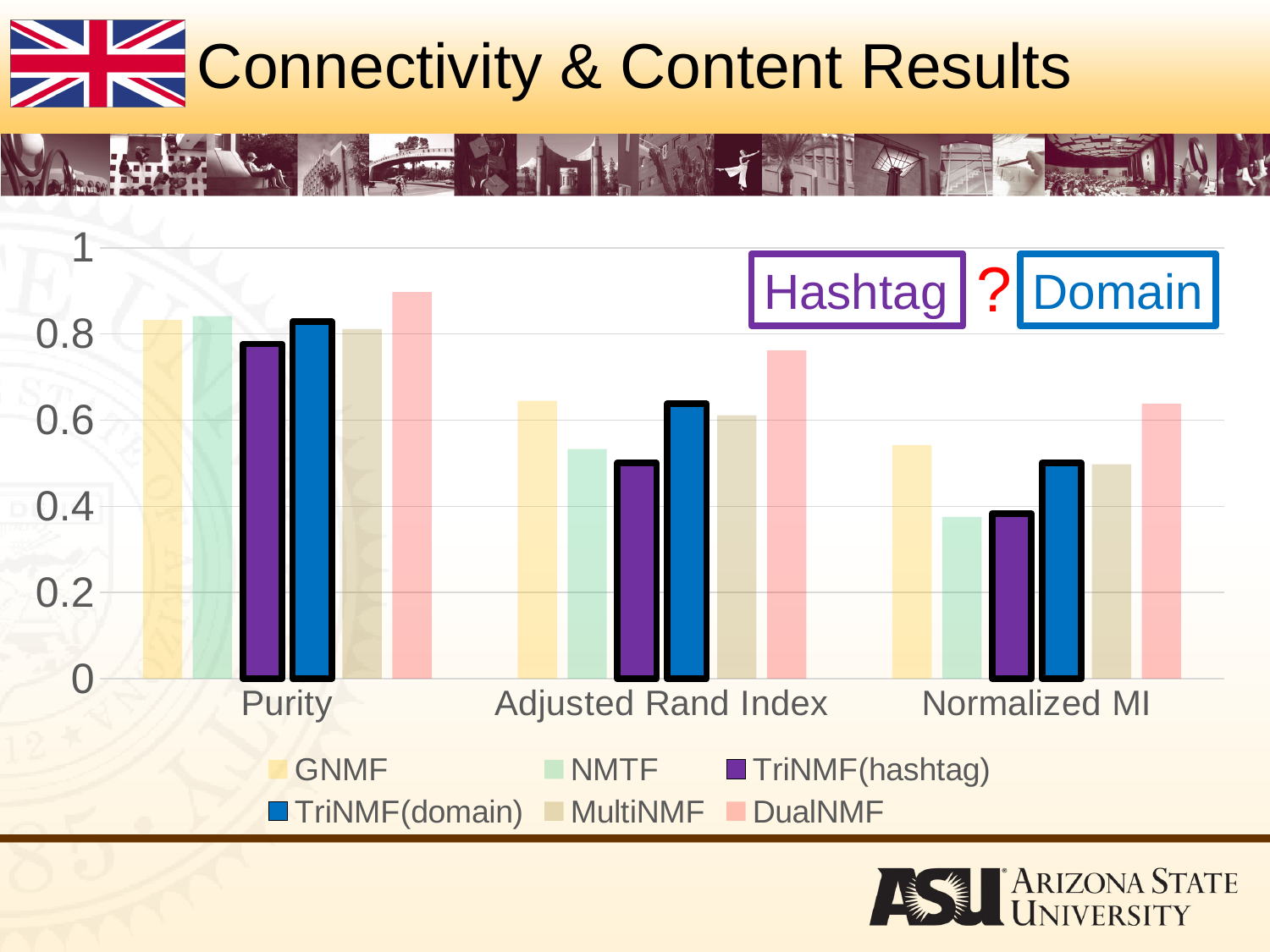
Is the value of TriNMF(hashtag) for Adjusted Rand Index greater or less than 0.6? less Is the value of GNMF for Normalized MI greater or less than 0.6? less Which series has the highest value for Purity? DualNMF Which series has the highest value for Adjusted Rand Index? DualNMF How many series does the chart's legend list? 6 Which two series are drawn with bold black outlines in the chart? TriNMF(hashtag) and TriNMF(domain) For Normalized MI, which is larger: TriNMF(domain) or TriNMF(hashtag)? TriNMF(domain) How many categories are shown on the x axis of the chart? 3 Do the DualNMF values rise or fall moving from Purity to Adjusted Rand Index to Normalized MI? fall Is the value of DualNMF for Purity greater or less than 0.8? greater Which series has the lowest value for Purity? TriNMF(hashtag) What kind of chart is shown on the slide? bar chart